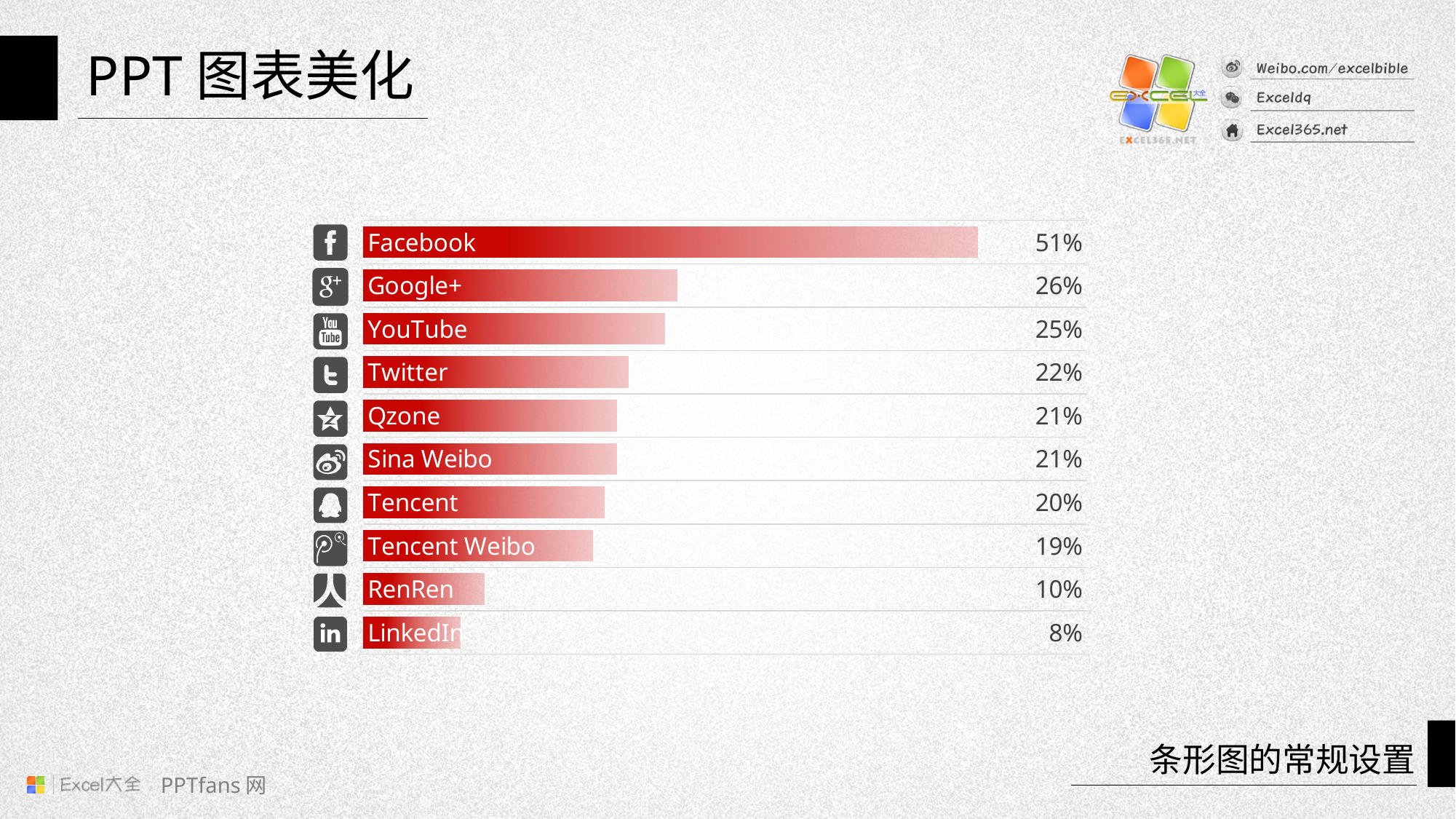
Which category has the lowest value? LinkedIn Which category has the highest value? Facebook What kind of chart is shown on the slide? Bar chart Which has a larger value, YouTube or Tencent? YouTube What colour are the bars in the chart? Red What is the difference between the values for Facebook and Google+? 25% Do the values rise or fall going from the top bar to the bottom bar? Fall What is the value for Tencent Weibo? 19% What is the difference between the values for RenRen and LinkedIn? 2% How many categories are shown in the chart? 10 What is the value for Facebook? 51% What is the value for Twitter? 22%